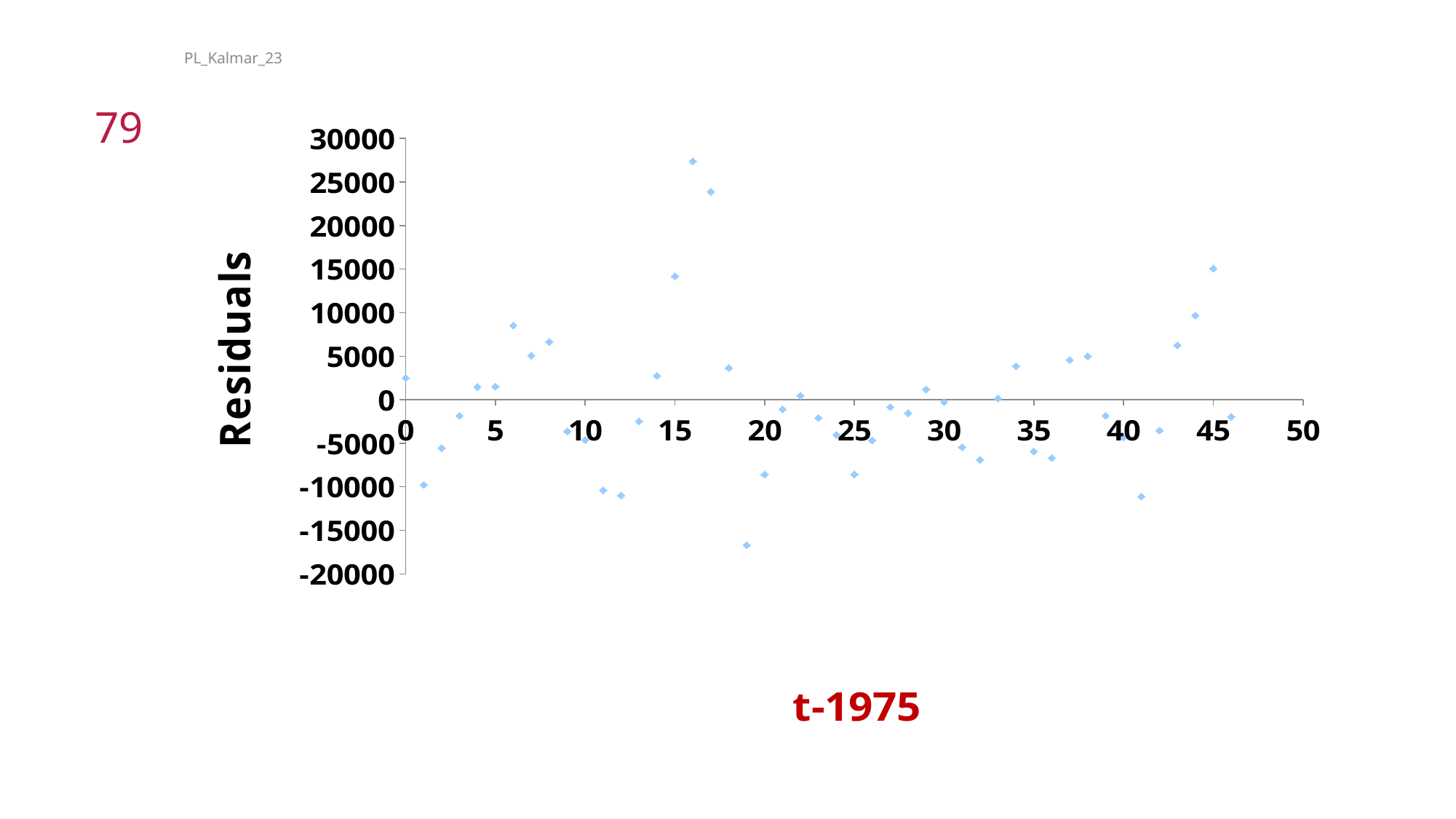
At which x value (t-1975) does the lowest residual occur? 19 Which residual is larger, the one at t-1975 = 16 or the one at t-1975 = 45? t-1975 = 16 At which x value (t-1975) does the highest residual occur? 16 Is the residual at t-1975 = 1 greater or less than -5000? less What is the label of the horizontal axis? t-1975 What is the label of the vertical axis? Residuals Which residual is larger, the one at t-1975 = 19 or the one at t-1975 = 11? t-1975 = 11 Is the residual at t-1975 = 19 greater or less than -15000? less What kind of chart is shown on the slide? scatter plot Is the residual at t-1975 = 17 greater or less than 20000? greater